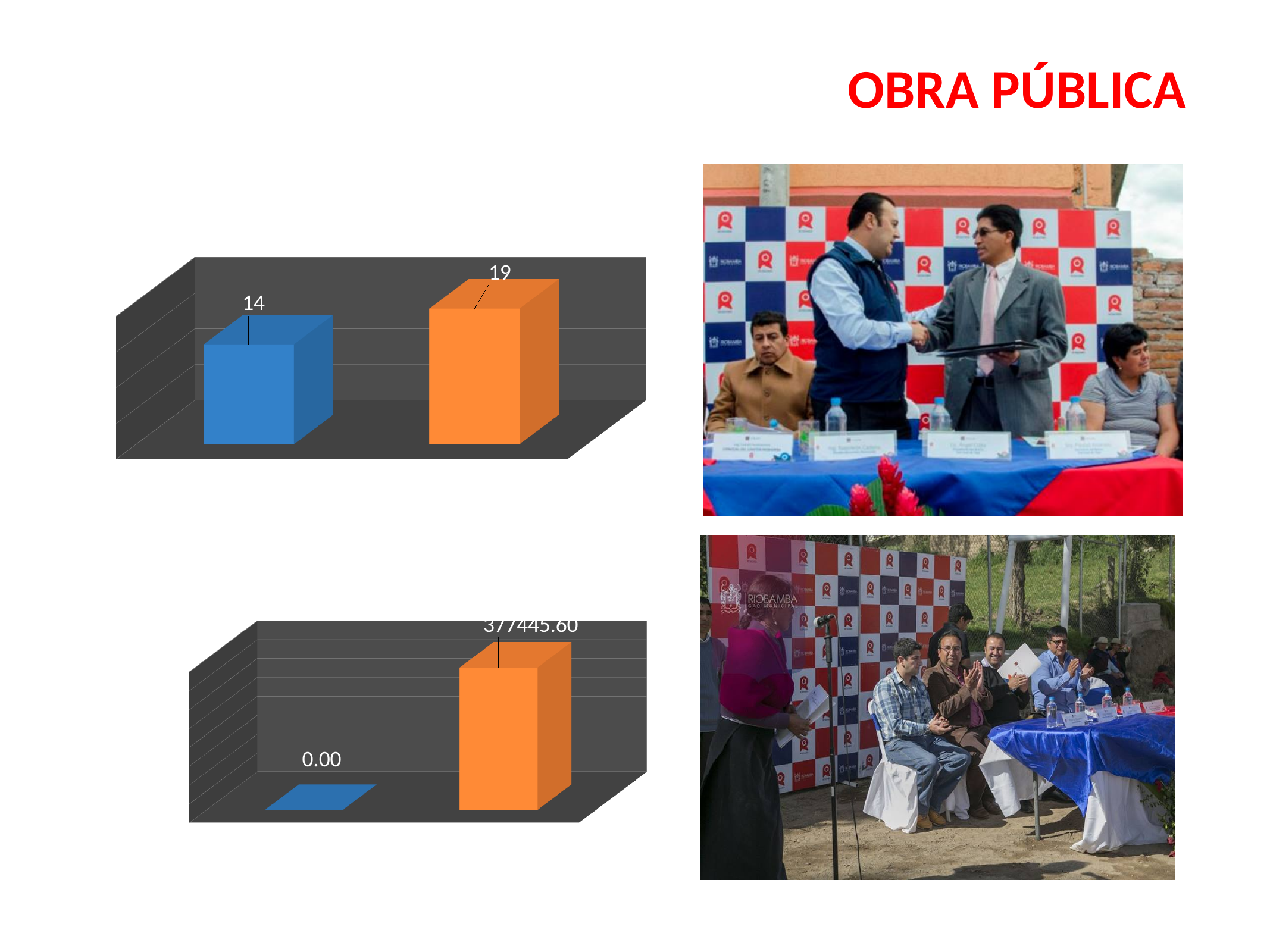
What is the title printed in red at the top of the slide? OBRA PÚBLICA In the top chart, what value is shown on the blue bar? 14 In the top chart, what value is shown on the orange bar? 19 How many bars are plotted in the top chart? 2 What kind of chart is the top chart? bar chart In the bottom chart, what is the difference between the orange bar's value and the blue bar's value? 377445.60 How many bars are plotted in the bottom chart? 2 In the bottom chart, which bar has the lower value, the blue one or the orange one? the blue one In the bottom chart, what value is shown on the orange bar? 377445.60 In the top chart, what is the difference between the orange bar's value and the blue bar's value? 5 In the top chart, which bar is taller, the blue one or the orange one? the orange one In the bottom chart, what value is shown on the blue bar? 0.00